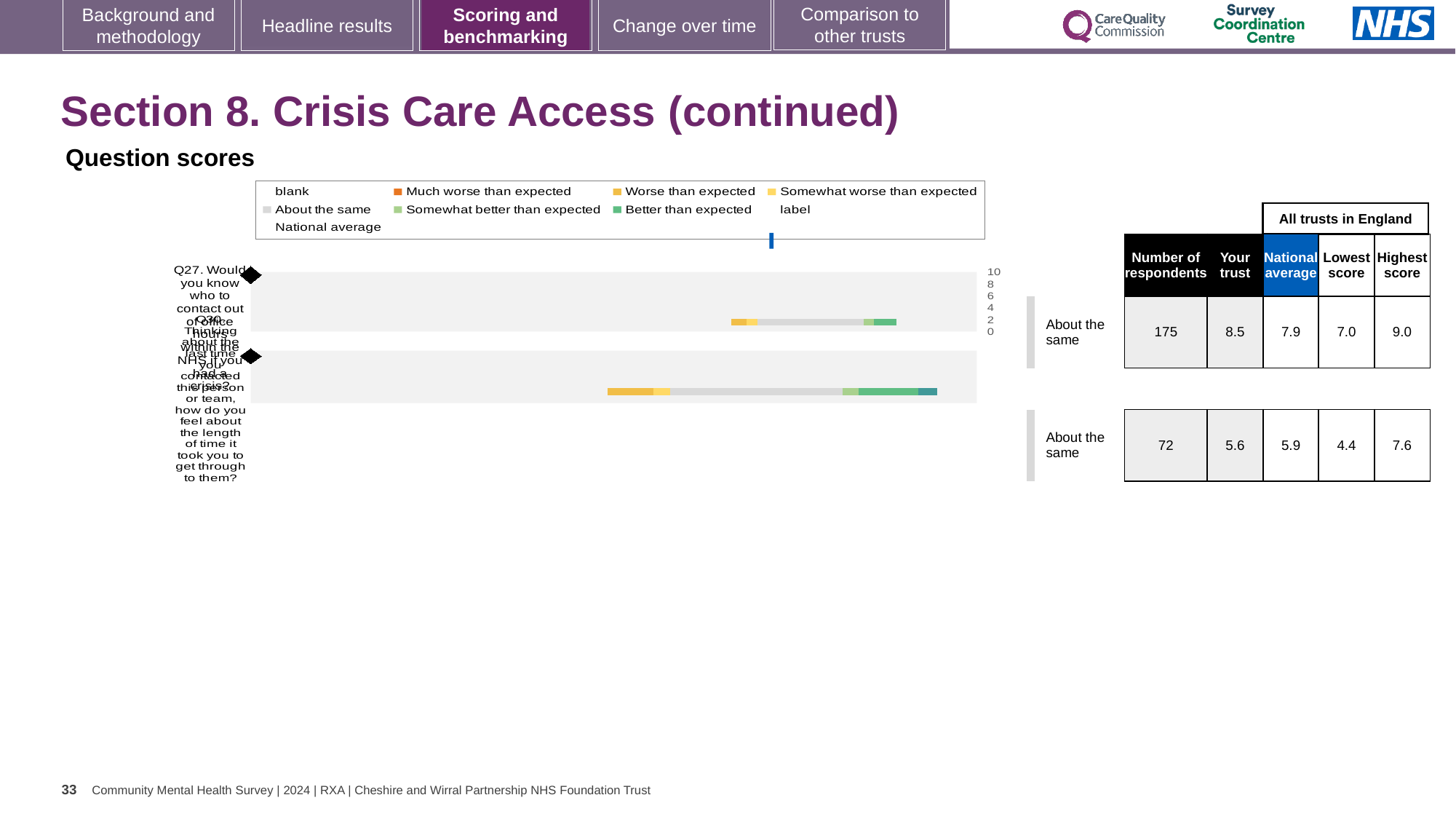
What is the lowest score across all trusts in England for Q27? 7.0 What is the highest score across all trusts in England for Q30? 7.6 What benchmark category is shown next to both Q27 and Q30? About the same Which legend entry is shown in orange? Much worse than expected How many respondents answered Q27? 175 Which question has more respondents, Q27 or Q30? Q27 What is the 'Your trust' score for Q27? 8.5 Is the 'Your trust' score for Q30 greater or less than the national average for Q30? less What kind of chart is shown under 'Question scores'? bar chart What is the national average score for Q30? 5.9 What is the difference between the 'Your trust' score and the national average for Q27? 0.6 How many questions (categories) are plotted in the chart? 2